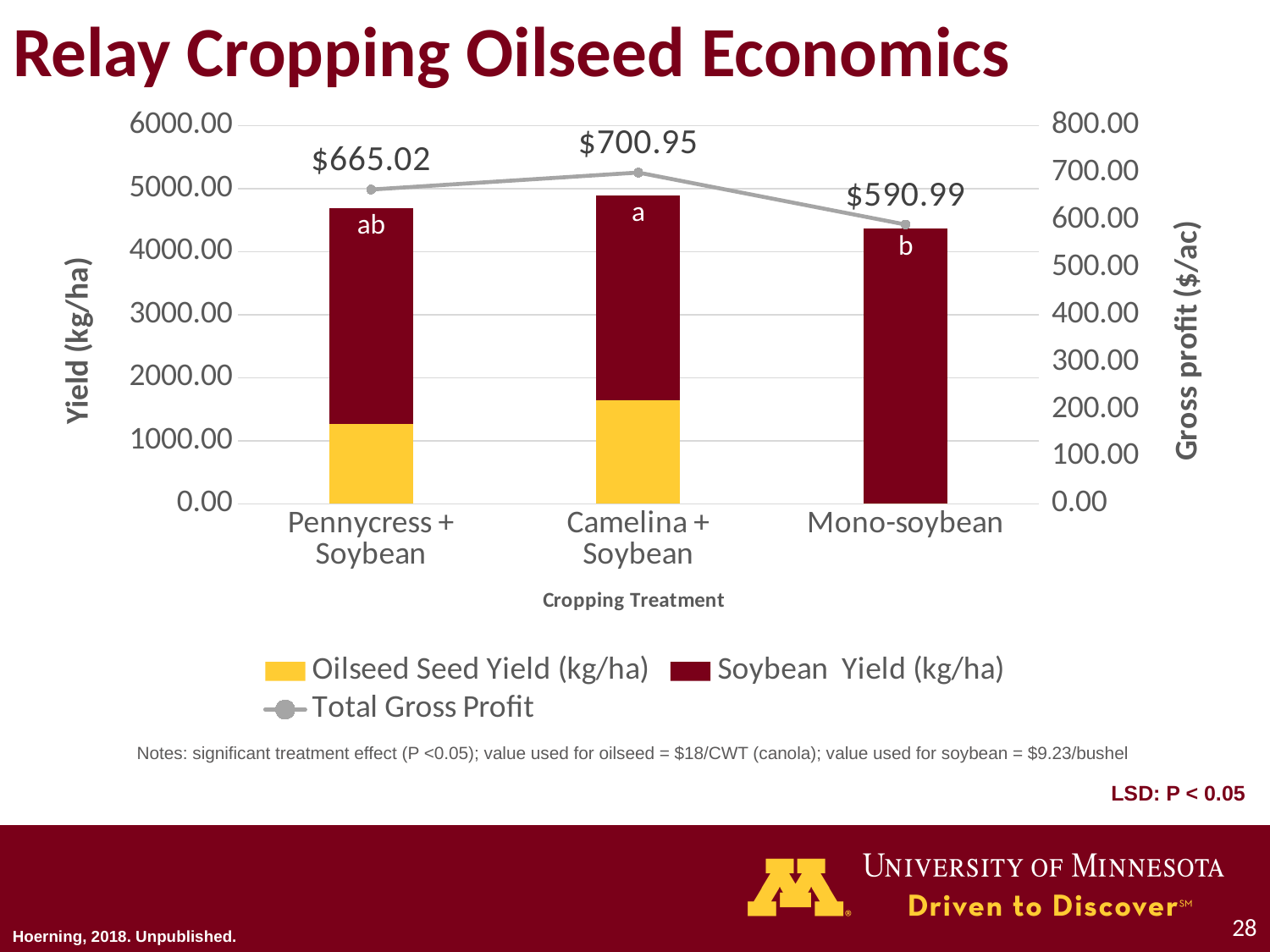
How many cropping treatments are shown on the x axis? 3 Is the total yield bar for Mono-soybean greater or less than 4000 kg/ha? greater What is the Total Gross Profit for Pennycress + Soybean? $665.02 Which cropping treatment has the lowest Total Gross Profit? Mono-soybean Which has a larger Total Gross Profit, Pennycress + Soybean or Mono-soybean? Pennycress + Soybean What is the Total Gross Profit for Camelina + Soybean? $700.95 What is the difference in Total Gross Profit between Camelina + Soybean and Mono-soybean? $109.96 What is the label of the right-hand vertical axis? Gross profit ($/ac) Which cropping treatment has the highest Total Gross Profit? Camelina + Soybean How many series does the legend list? 3 What is the Total Gross Profit for Mono-soybean? $590.99 Is the Oilseed Seed Yield for Camelina + Soybean greater or less than 1000 kg/ha? greater